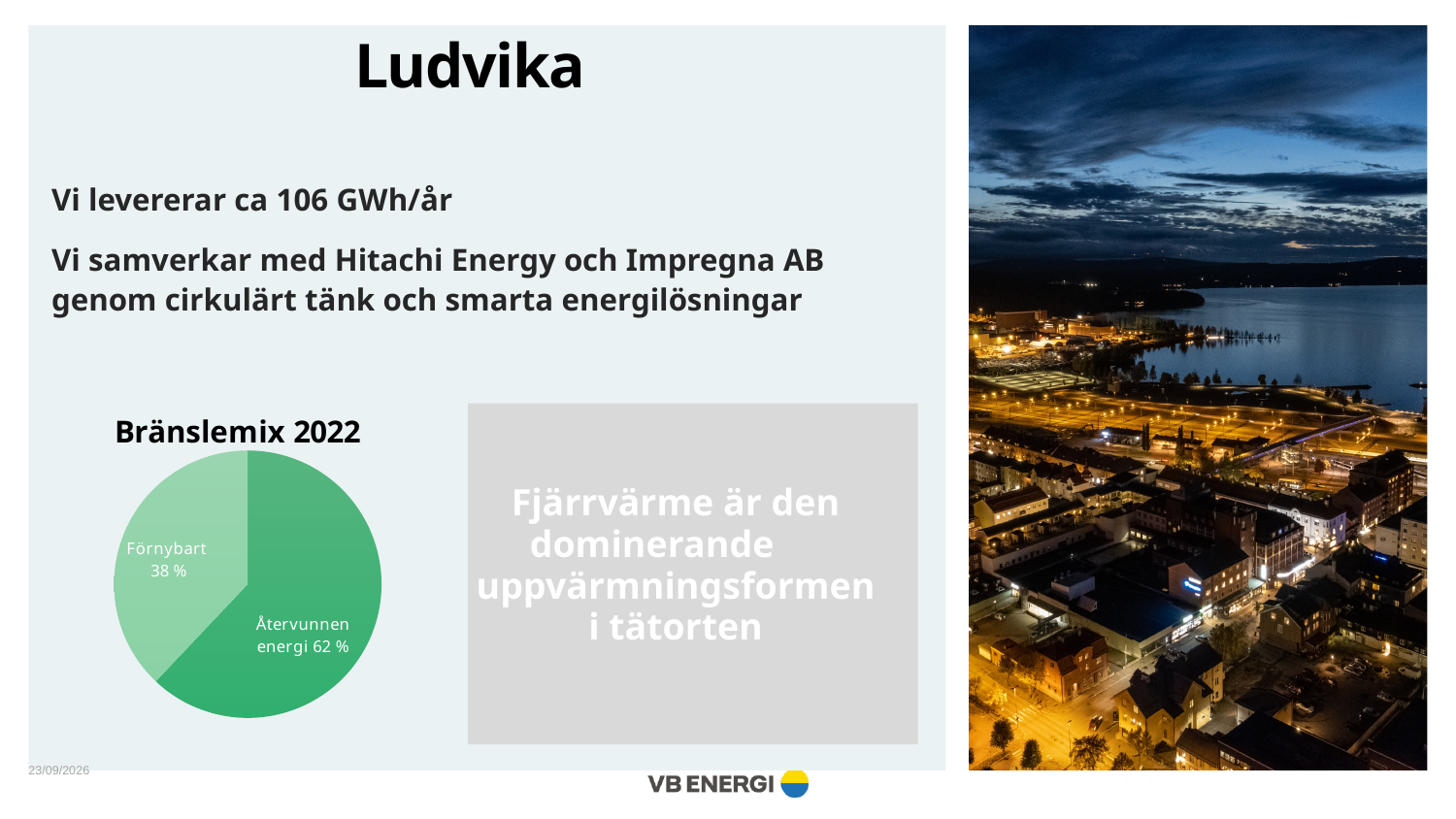
What share of the pie does "Förnybart" have? 38 % What is the title of the chart on the slide? Bränslemix 2022 Which is larger in the pie chart, "Förnybart" or "Återvunnen energi"? Återvunnen energi Which slice of the pie chart is the largest? Återvunnen energi What kind of chart is shown under the title "Bränslemix 2022"? Pie chart How many slices does the pie chart have? 2 Is the share for "Återvunnen energi" greater or less than 50 %? greater What is the difference in percentage points between "Återvunnen energi" and "Förnybart"? 24 percentage points What is the total of the two slices in the pie chart? 100 % Which slice of the pie chart is the smallest? Förnybart Is the share for "Förnybart" greater or less than 50 %? less What share of the pie does "Återvunnen energi" have? 62 %